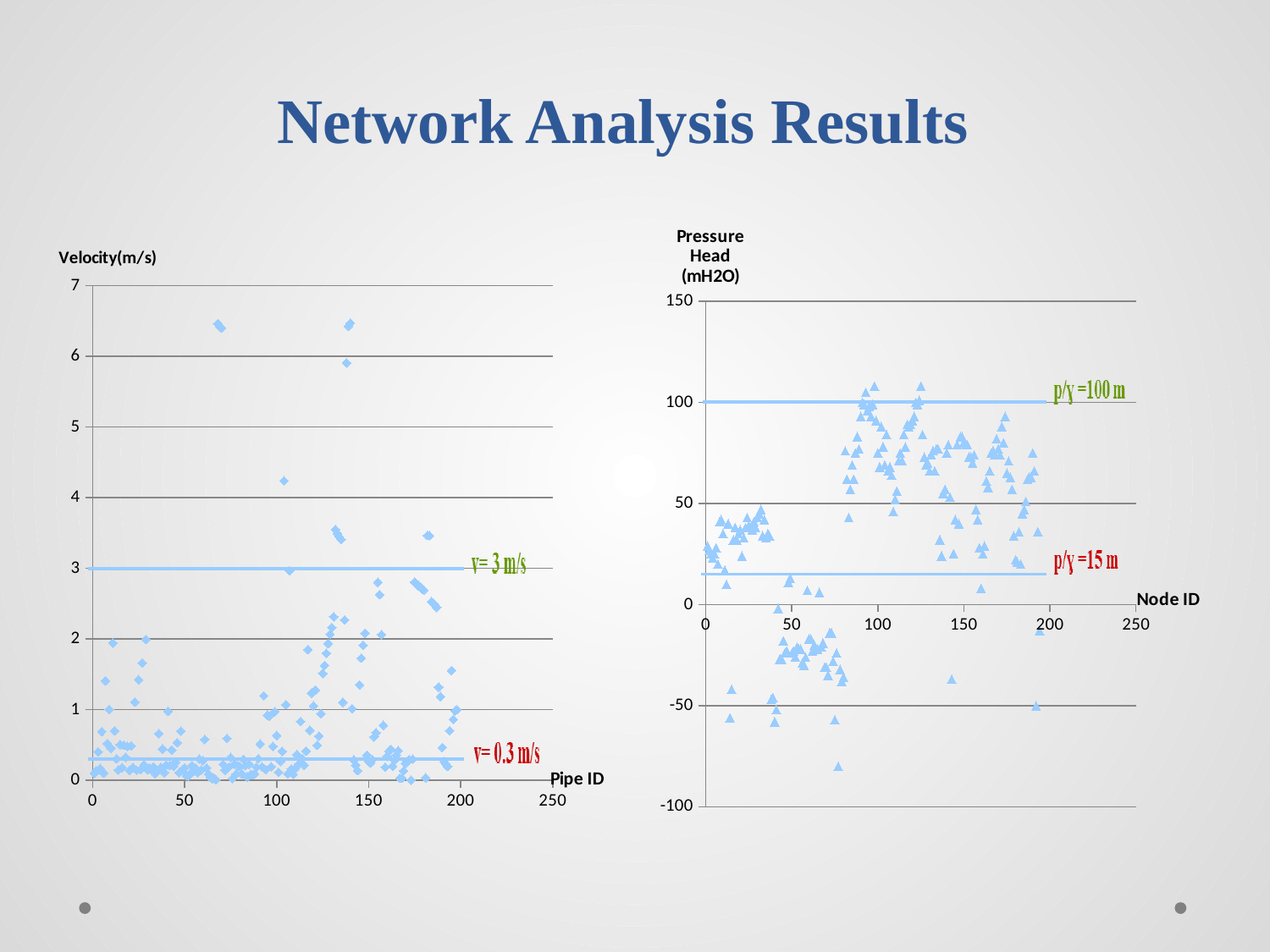
What kind of chart is the left chart on the slide (Velocity vs Pipe ID)? scatter chart On the left chart, what velocity value does the lower reference line mark? v= 0.3 m/s On the right chart, what is the minimum value shown on the vertical axis? -100 On the right chart, is the highest plotted pressure head greater or less than 100? greater On the right chart, what pressure head value does the lower reference line mark? p/γ =15 m On the left chart, what velocity value does the upper reference line mark? v= 3 m/s On the right chart, what is the label of the horizontal axis? Node ID On the right chart, is the lowest plotted pressure head greater or less than -50? less On the right chart, what pressure head value does the upper reference line mark? p/γ =100 m What kind of chart is the right chart on the slide (Pressure Head vs Node ID)? scatter chart On the left chart, what is the label of the vertical axis? Velocity(m/s) On the left chart, is the highest plotted velocity greater or less than 6? greater